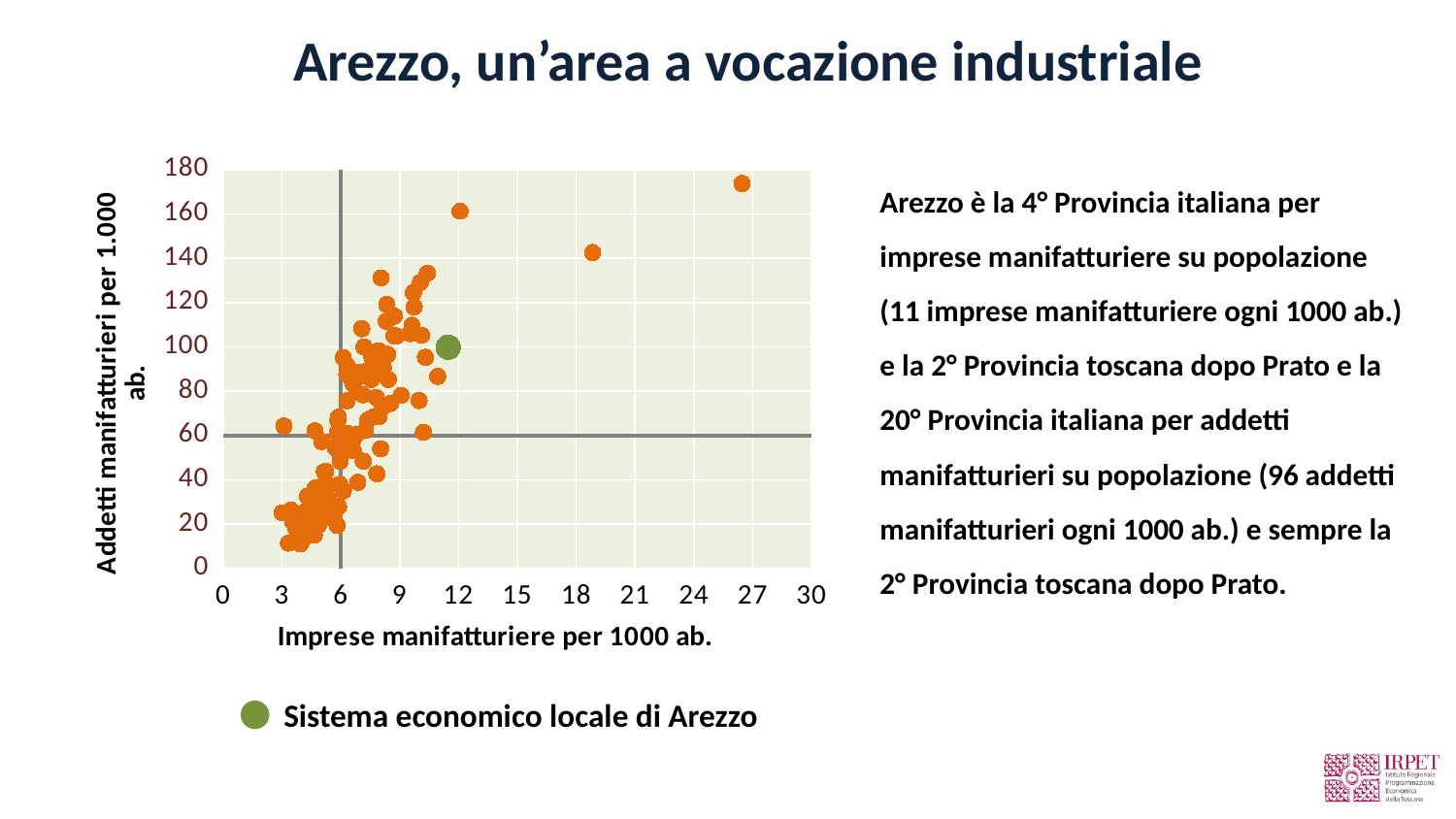
What is the label of the x axis? Imprese manifatturiere per 1000 ab. What kind of chart is shown on the slide? scatter chart At what y-axis value is the horizontal reference line drawn? 60 What is the maximum value shown on the y axis? 180 How many series does the chart legend list? 1 At what x-axis value is the vertical reference line drawn? 6 Is the x value of the rightmost point in the chart greater or less than 24? greater Is the x value of the green point for Sistema economico locale di Arezzo greater or less than 15? less Is the y value of the highest point in the chart greater or less than 160? greater What is the legend entry for the green point? Sistema economico locale di Arezzo